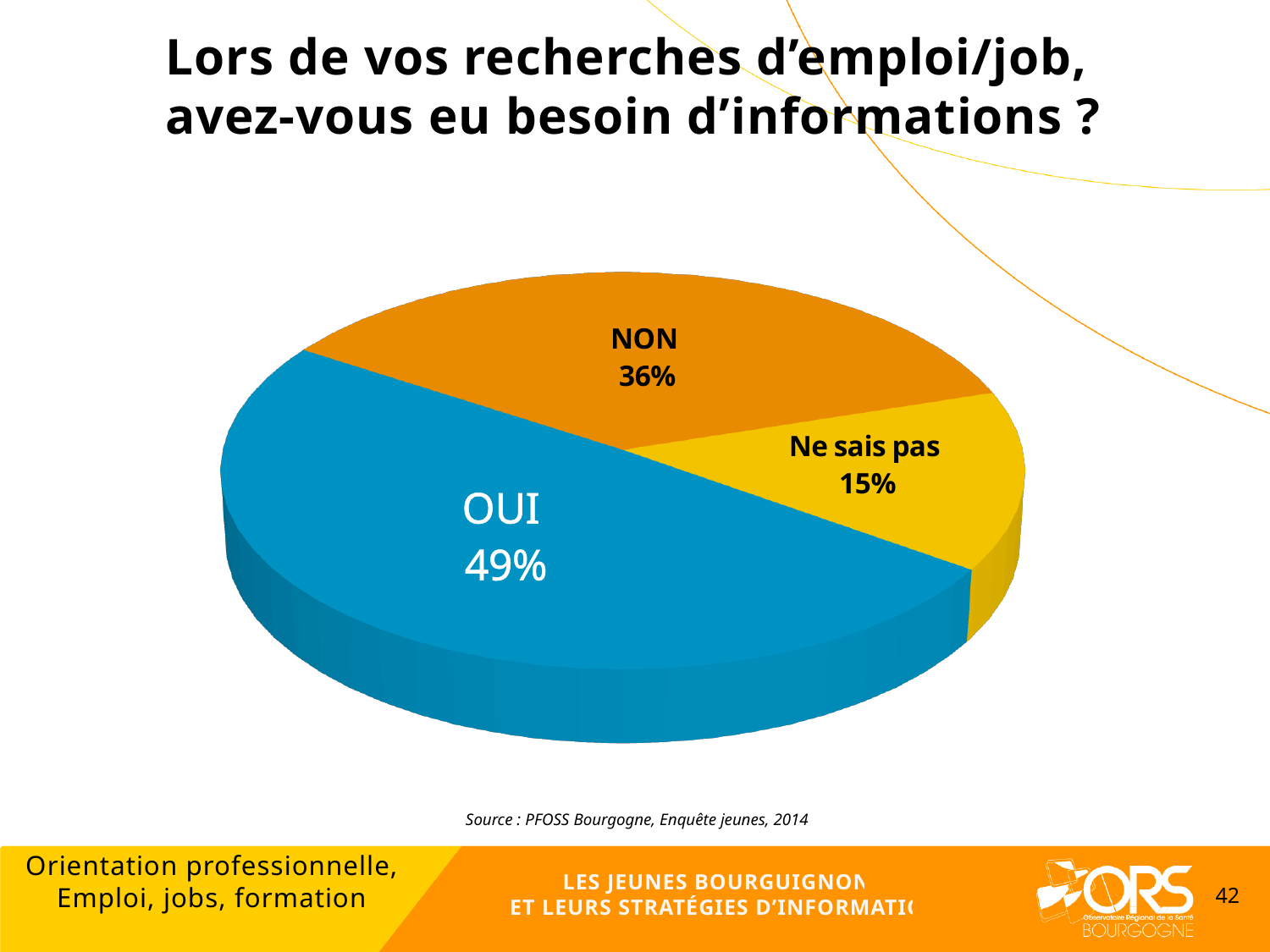
Which is larger, the share for NON or the share for Ne sais pas? NON What is the source cited below the chart? PFOSS Bourgogne, Enquête jeunes, 2014 Which response has the largest share of the pie? OUI What is the difference in percentage points between OUI and NON? 13 What percentage of respondents answered OUI? 49% How many slices does the pie chart have? 3 What is the difference in percentage points between NON and Ne sais pas? 21 What colour is the OUI slice? Blue What kind of chart is shown on the slide? Pie chart What percentage of respondents answered Ne sais pas? 15% What percentage of respondents answered NON? 36% Which response has the smallest share of the pie? Ne sais pas